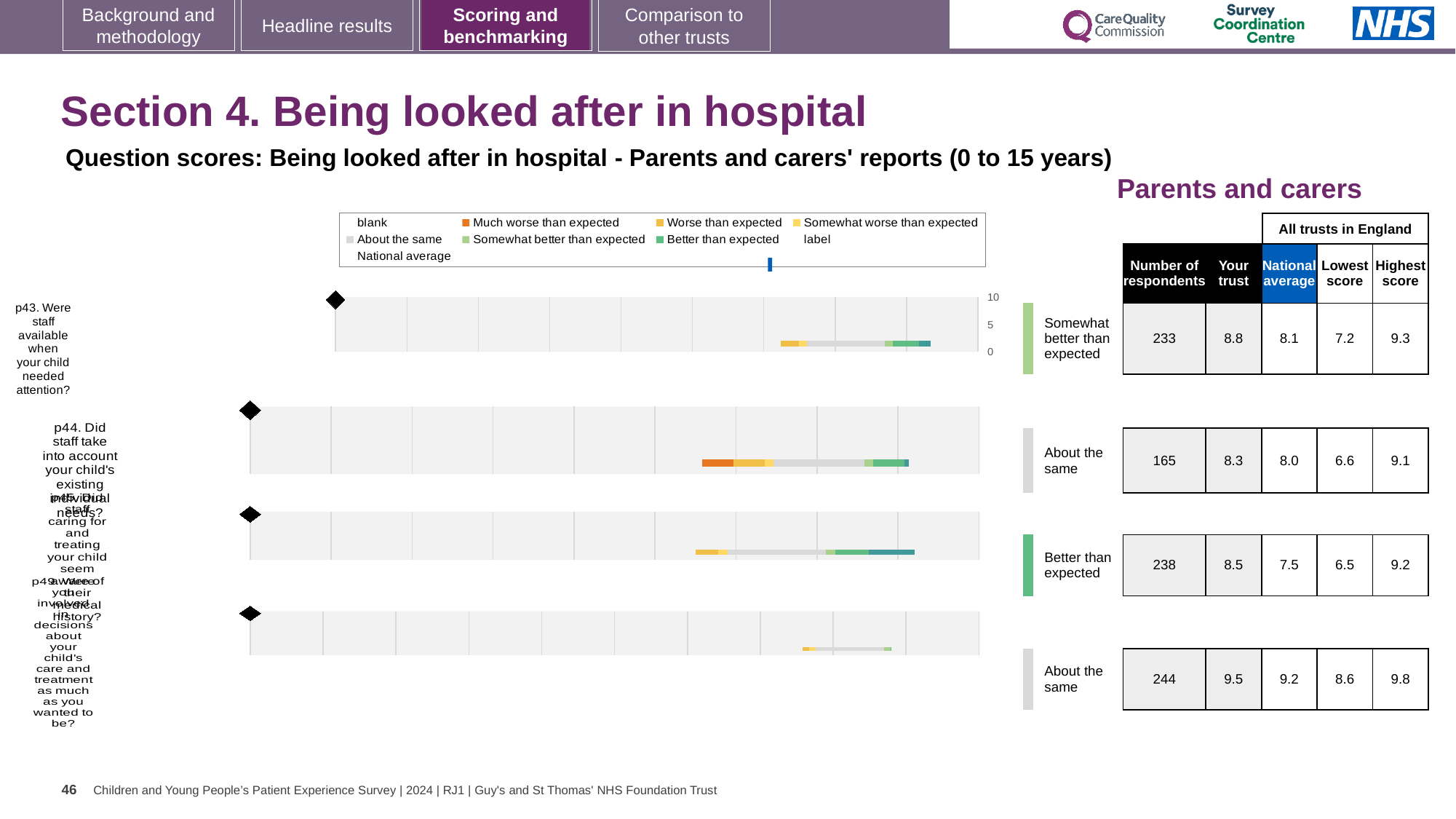
For the first row (p43), what is the difference between the 'Your trust' score and the 'National average' score? 0.7 What does the blue vertical marker in the legend represent? National average Which row of the table has the highest 'Your trust' score? the fourth row (p49), 9.5 In the legend, what colour represents 'Much worse than expected'? orange How many question charts (p43, p44, p45, p49) are shown on the slide? 4 How many respondents are listed for the fourth row (p49)? 244 What benchmark category is shown for the third row (p45)? Better than expected In the table beside the charts, what is the 'National average' score for the first row (p43)? 8.1 Which row of the table has the lowest 'Your trust' score? the second row (p44), 8.3 What kind of chart is used to show the question scores on this slide? bar chart In the table beside the charts, what is the 'Your trust' score for the first row (p43, staff available when your child needed attention)? 8.8 For the third row (p45), which is larger: the 'Your trust' score or the 'National average' score? Your trust (8.5)